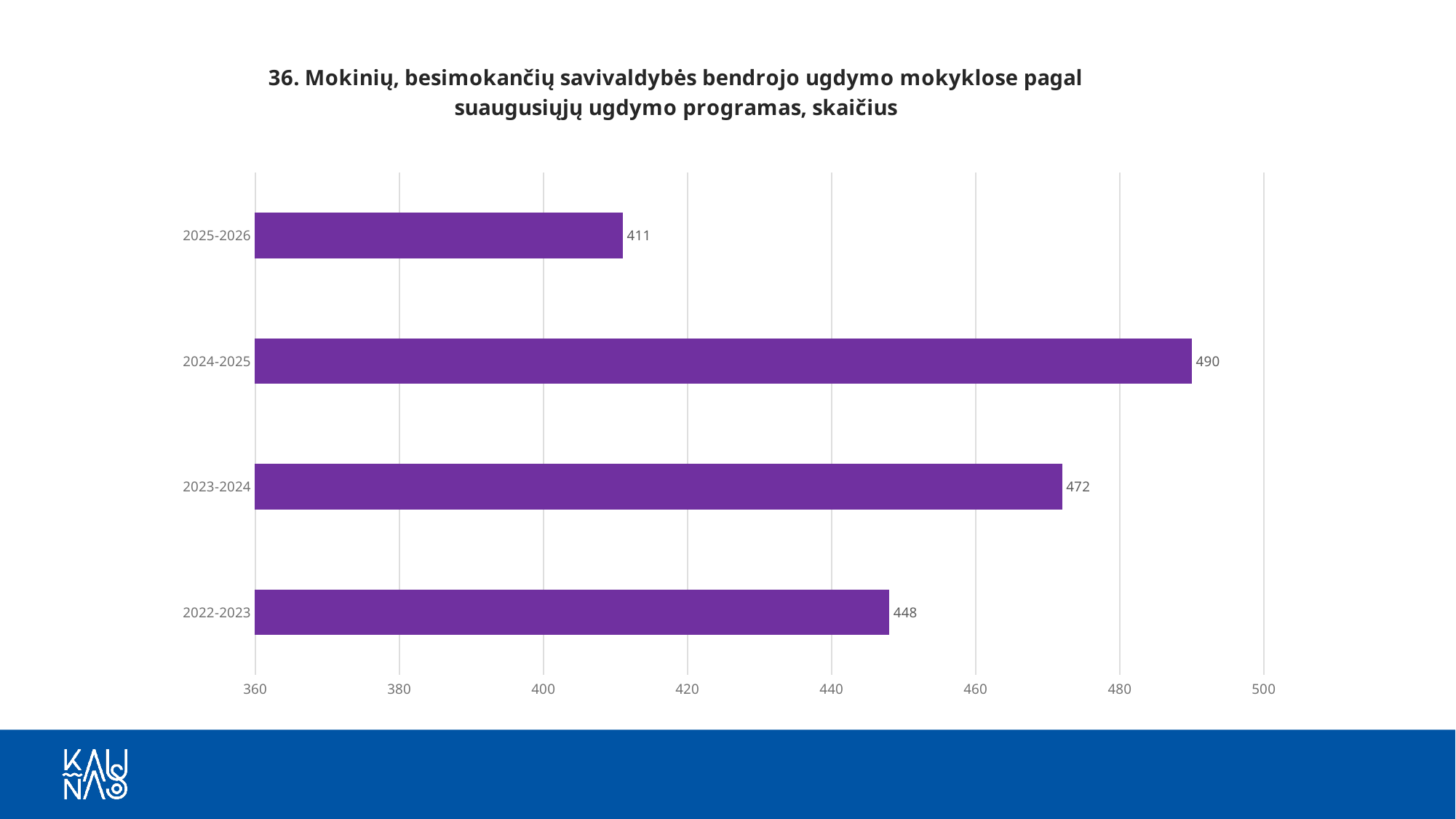
Which is larger, the value for 2022-2023 or the value for 2023-2024? 2023-2024 Which school year has the lowest value? 2025-2026 How many school years are shown in the chart? 4 Is the value for 2025-2026 greater or less than 420? less Which school year has the highest value? 2024-2025 What is the value for 2023-2024? 472 What is the difference between the values for 2024-2025 and 2025-2026? 79 What is the value for 2024-2025? 490 What is the difference between the values for 2023-2024 and 2022-2023? 24 What kind of chart is shown on the slide? bar chart What is the value for 2022-2023? 448 What is the value for 2025-2026? 411